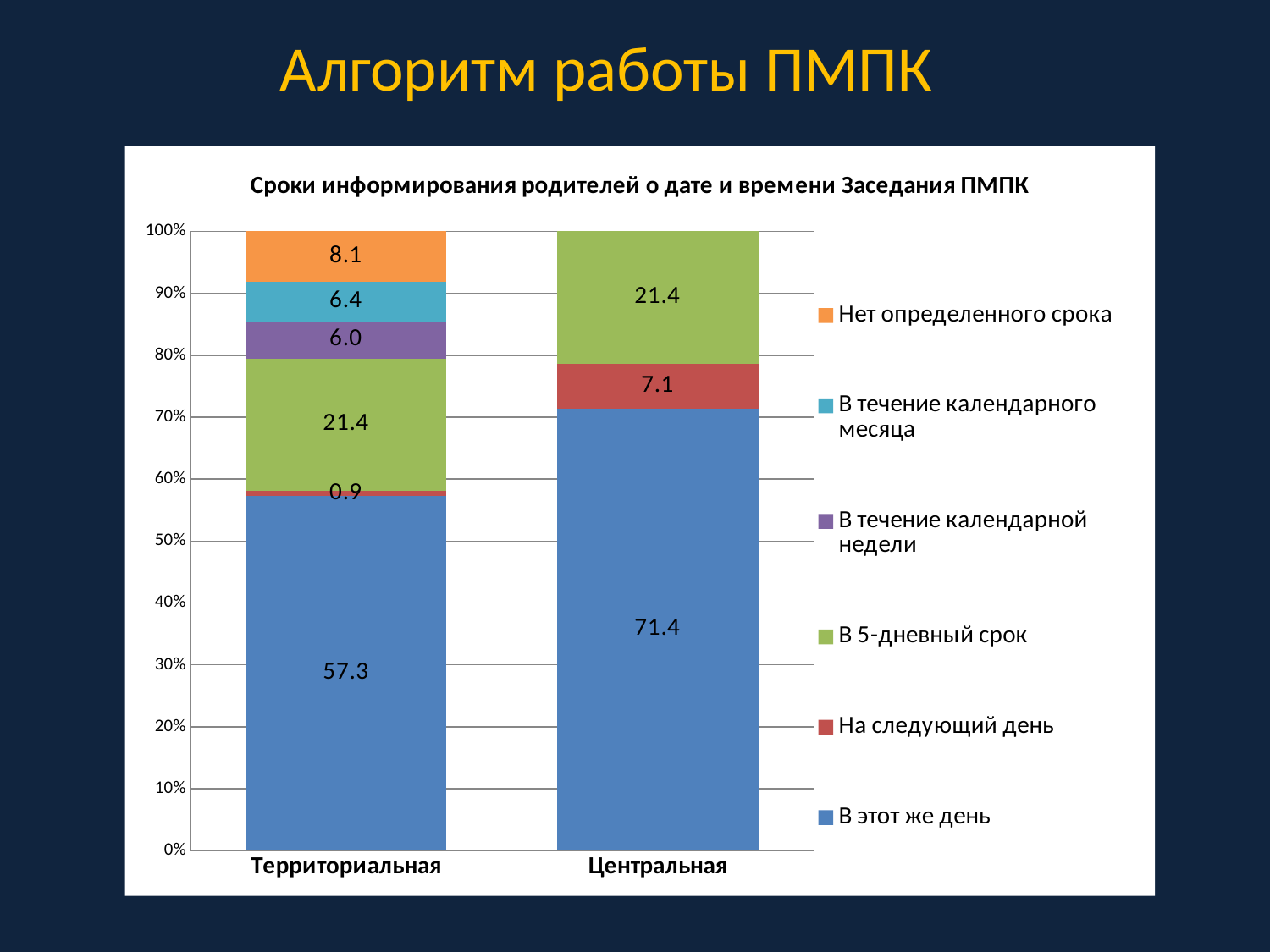
What is the value for 'На следующий день' in the 'Центральная' bar? 7.1 What is the value for 'Нет определенного срока' in the 'Территориальная' bar? 8.1 Which segment is the largest in the 'Центральная' bar? В этот же день What is the value for 'В этот же день' in the 'Центральная' bar? 71.4 What kind of chart is shown on the slide? Stacked bar chart What is the value for 'В этот же день' in the 'Территориальная' bar? 57.3 What is the difference between the 'В этот же день' values for 'Центральная' and 'Территориальная'? 14.1 How many categories are shown on the x axis? 2 How many series does the legend list? 6 What is the value for 'В течение календарной недели' in the 'Территориальная' bar? 6.0 Which bar has the larger value for 'На следующий день', 'Территориальная' or 'Центральная'? Центральная Which segment is the smallest in the 'Территориальная' bar? На следующий день